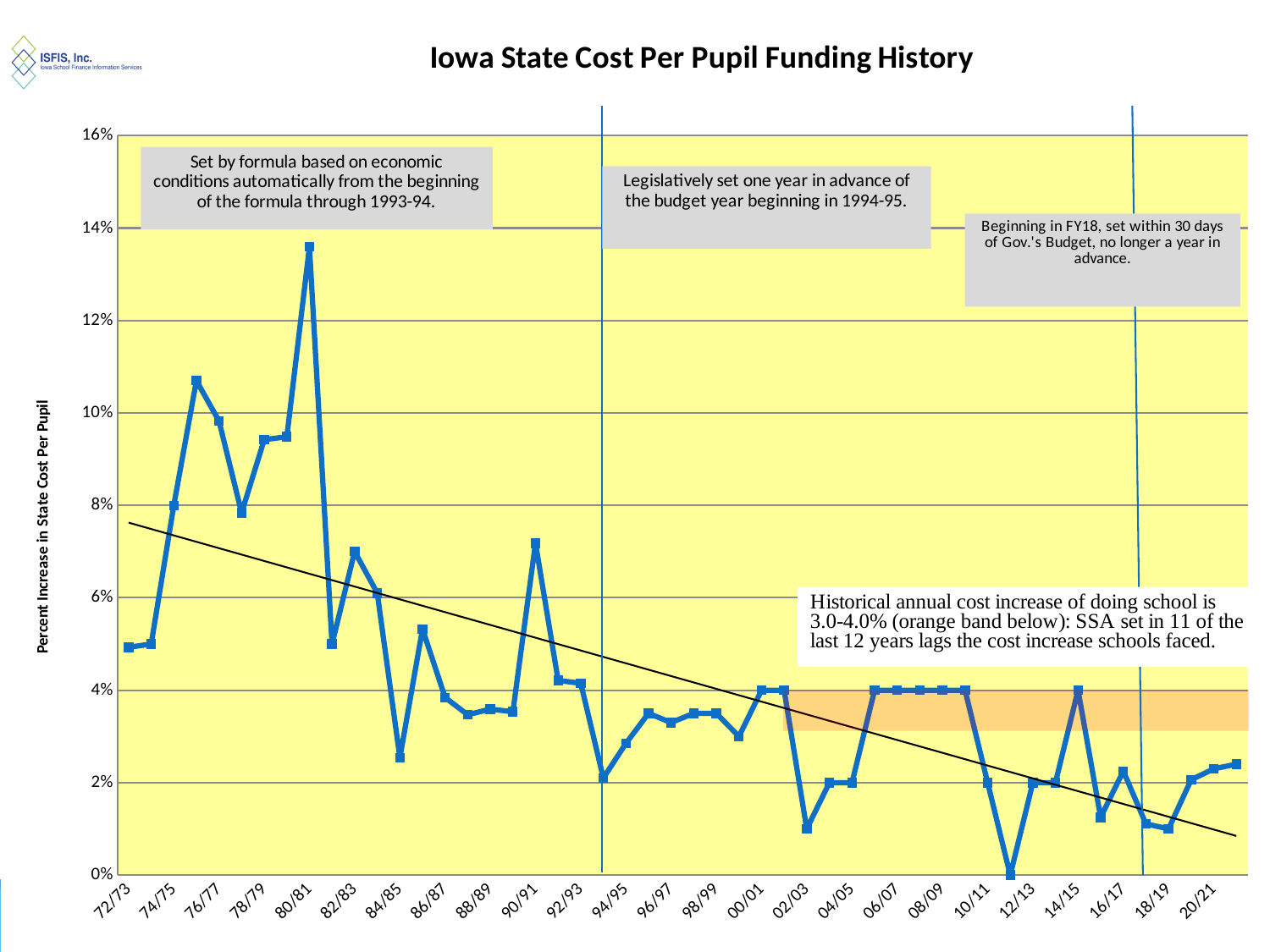
Which year has the larger percent increase, 80/81 or 90/91? 80/81 What is the title of the chart? Iowa State Cost Per Pupil Funding History What is the percent increase in state cost per pupil for 12/13? 2% What kind of chart is shown on the slide? line chart What is the percent increase in state cost per pupil for 00/01? 4% Is the value for 02/03 greater or less than 2%? less What is the label on the vertical axis of the chart? Percent Increase in State Cost Per Pupil Which year on the x axis has the lowest percent increase in state cost per pupil? 11/12 Which year on the x axis has the highest percent increase in state cost per pupil? 80/81 Is the value for 76/77 greater or less than 8%? greater Is the value for 84/85 greater or less than 4%? less Overall, do the values rise or fall from 72/73 to 20/21? fall